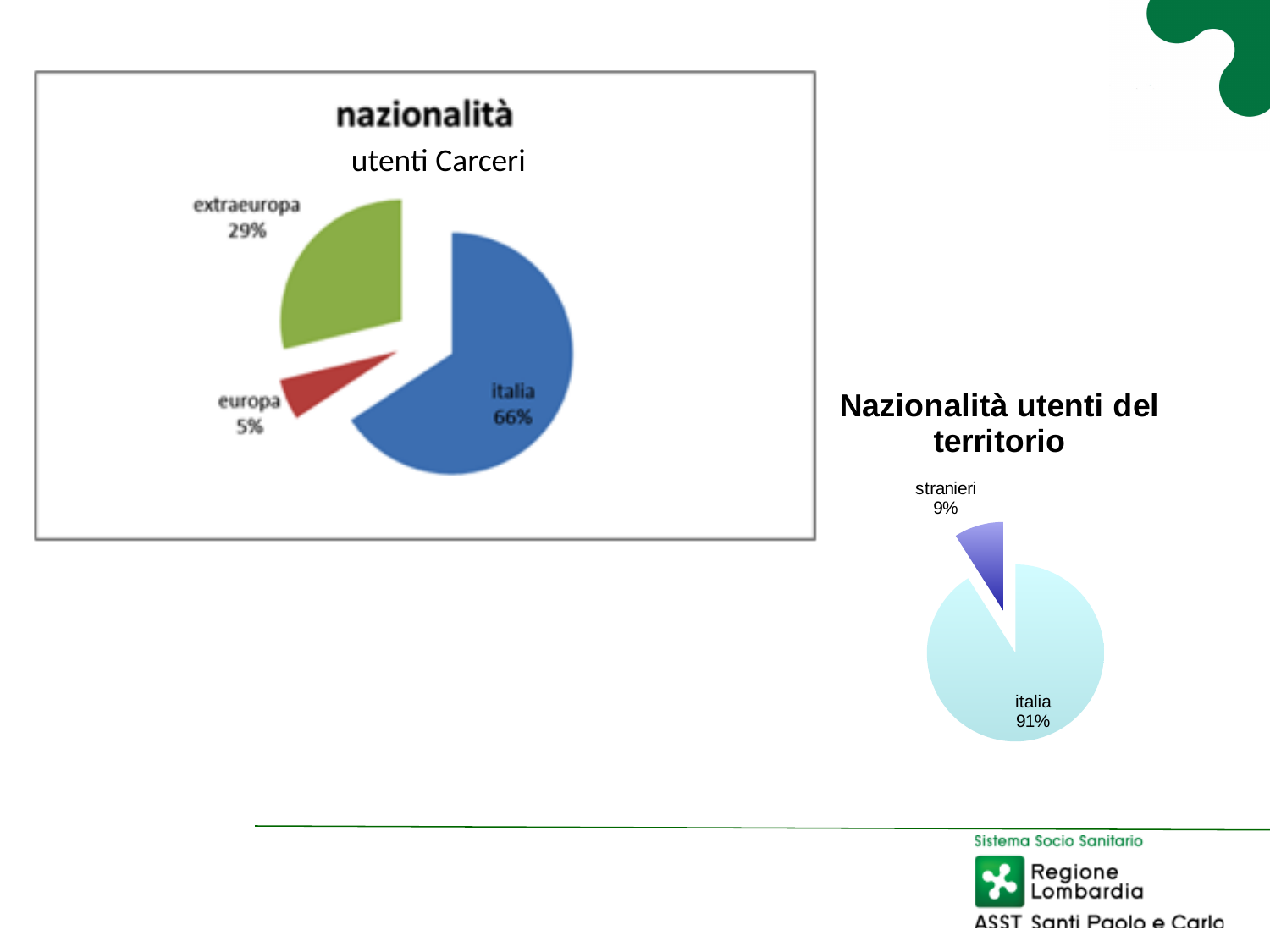
What type of chart is the 'Nazionalità utenti del territorio' chart? pie chart In the 'Nazionalità utenti del territorio' pie chart, what share is labelled for stranieri? 9% In the 'nazionalità utenti Carceri' pie chart, which category has the smallest slice? europa In the 'Nazionalità utenti del territorio' pie chart, which is larger, italia or stranieri? italia In the 'nazionalità utenti Carceri' pie chart, which category has the largest slice? italia In the 'nazionalità utenti Carceri' pie chart, how many percentage points larger is extraeuropa than europa? 24 In the 'nazionalità utenti Carceri' pie chart, what share is labelled for extraeuropa? 29% In the 'Nazionalità utenti del territorio' pie chart, what share is labelled for italia? 91% In the 'nazionalità utenti Carceri' pie chart, what share is labelled for italia? 66% In the 'Nazionalità utenti del territorio' pie chart, how many slices are there? 2 In the 'nazionalità utenti Carceri' pie chart, how many slices are there? 3 In the 'nazionalità utenti Carceri' pie chart, what share is labelled for europa? 5%